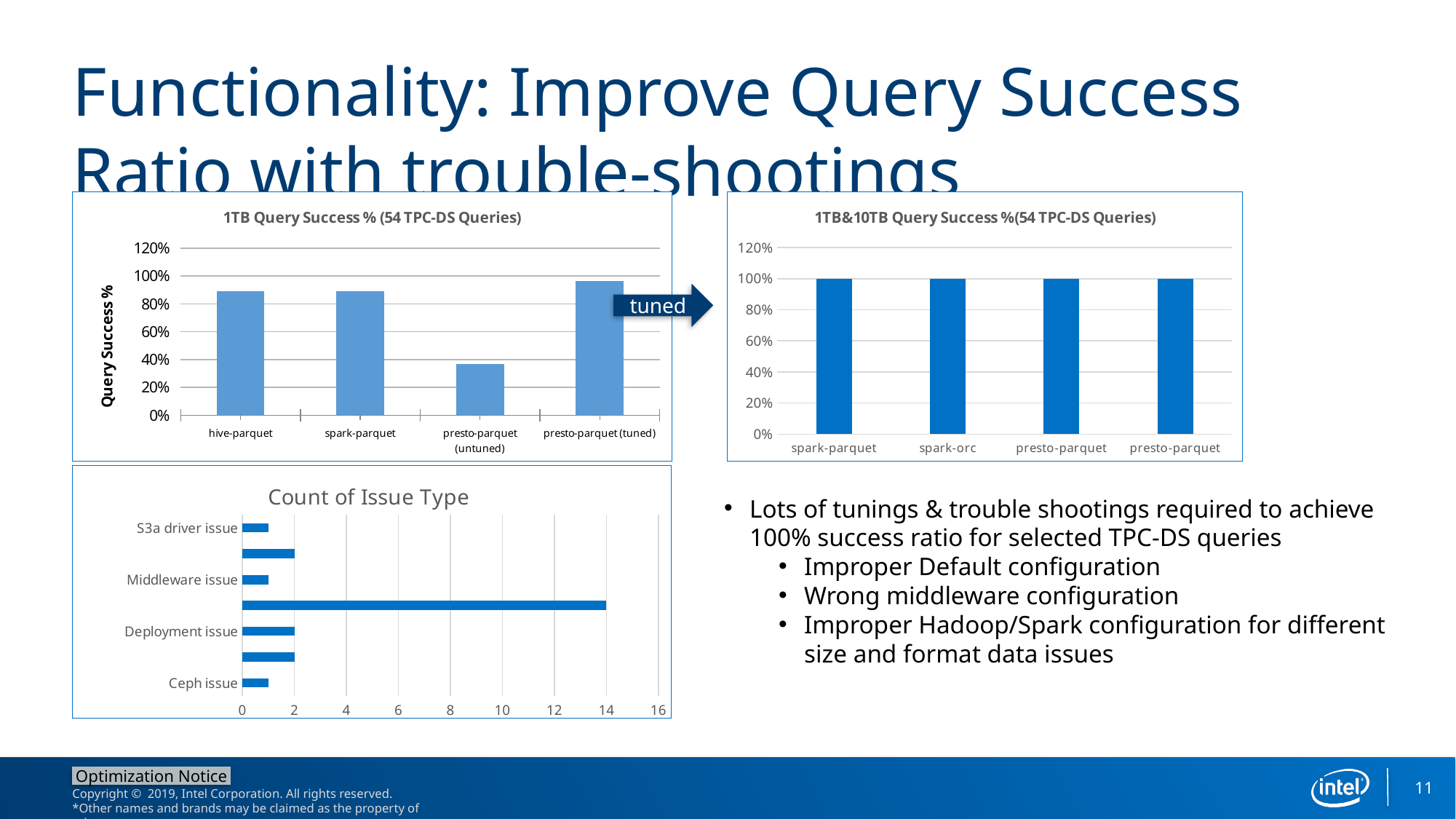
In the "1TB&10TB Query Success %(54 TPC-DS Queries)" chart, what is the value for spark-orc? 100% In the "Count of Issue Type" chart, is the value for S3a driver issue greater or less than 2? less In the "1TB Query Success % (54 TPC-DS Queries)" chart, which category has the lowest value? presto-parquet (untuned) How many categories are shown on the x axis of the "1TB Query Success % (54 TPC-DS Queries)" chart? 4 What kind of chart is the "Count of Issue Type" chart? bar chart In the "1TB Query Success % (54 TPC-DS Queries)" chart, which is larger: hive-parquet or presto-parquet (untuned)? hive-parquet In the "Count of Issue Type" chart, what is the value for Deployment issue? 2 In the "Count of Issue Type" chart, is the value for Ceph issue greater or less than 2? less How many bars are plotted in the "1TB&10TB Query Success %(54 TPC-DS Queries)" chart? 4 What is the y-axis label of the "1TB Query Success % (54 TPC-DS Queries)" chart? Query Success % In the "1TB Query Success % (54 TPC-DS Queries)" chart, which category has the highest value? presto-parquet (tuned) In the "1TB Query Success % (54 TPC-DS Queries)" chart, is the value for hive-parquet greater or less than 80%? greater